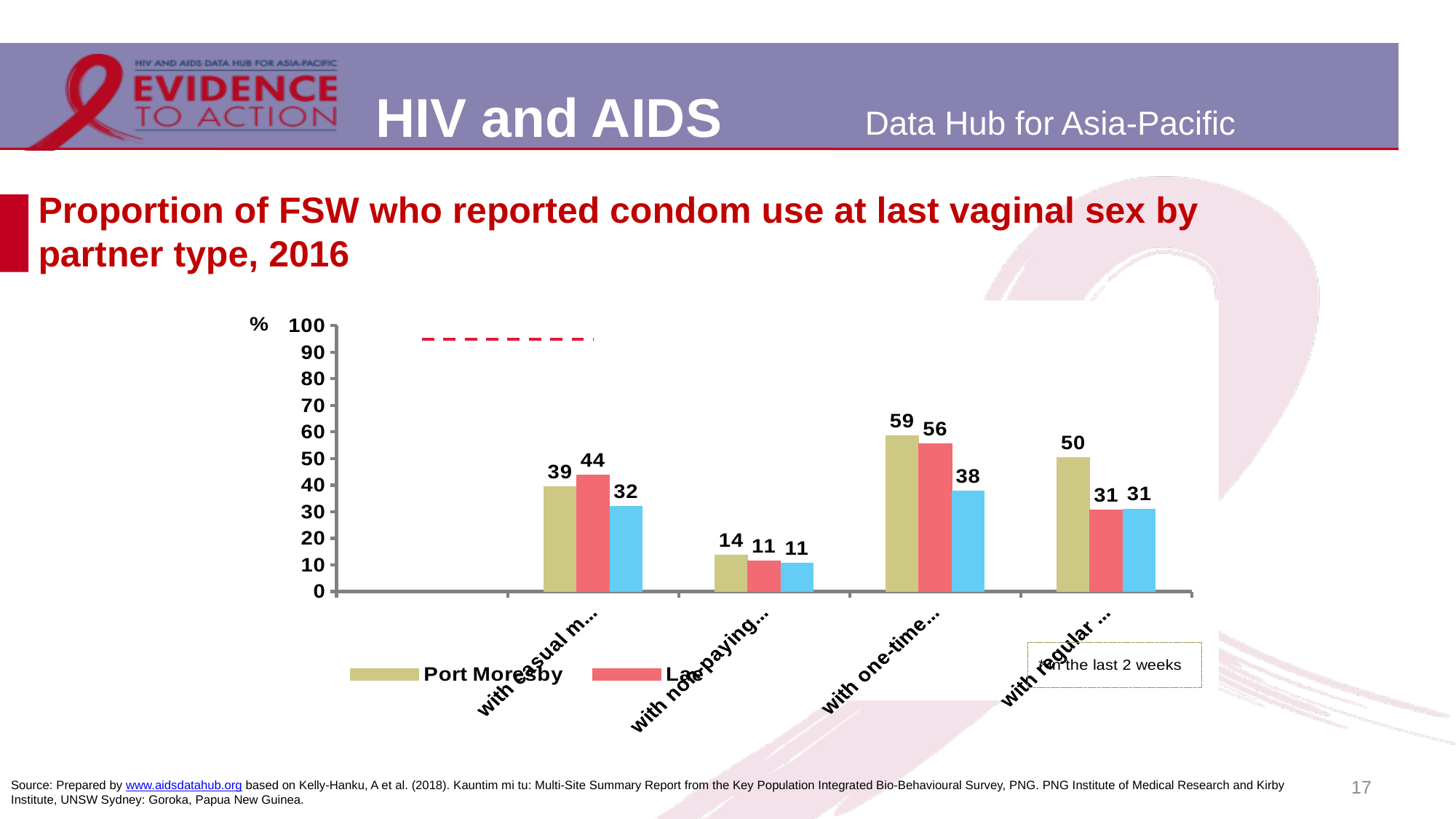
For the 'with one-time' partner type, what is the difference between the Port Moresby and Lae values? 3 What is the value for Lae for the 'with casual' partner type? 44 How many partner-type categories are shown on the x axis? 4 For the 'with regular' partner type, what is the difference between the Port Moresby and Lae values? 19 For which partner type is the Port Moresby value lowest? with non-paying For which partner type is the Port Moresby value highest? with one-time What is the value for Port Moresby for the 'with one-time' partner type? 59 What kind of chart is shown on the slide? bar chart For the 'with casual' partner type, which is larger: Port Moresby or Lae? Lae What is the value for Port Moresby for the 'with regular' partner type? 50 What is the value for Lae for the 'with non-paying' partner type? 11 What unit is shown on the y axis of the chart? %